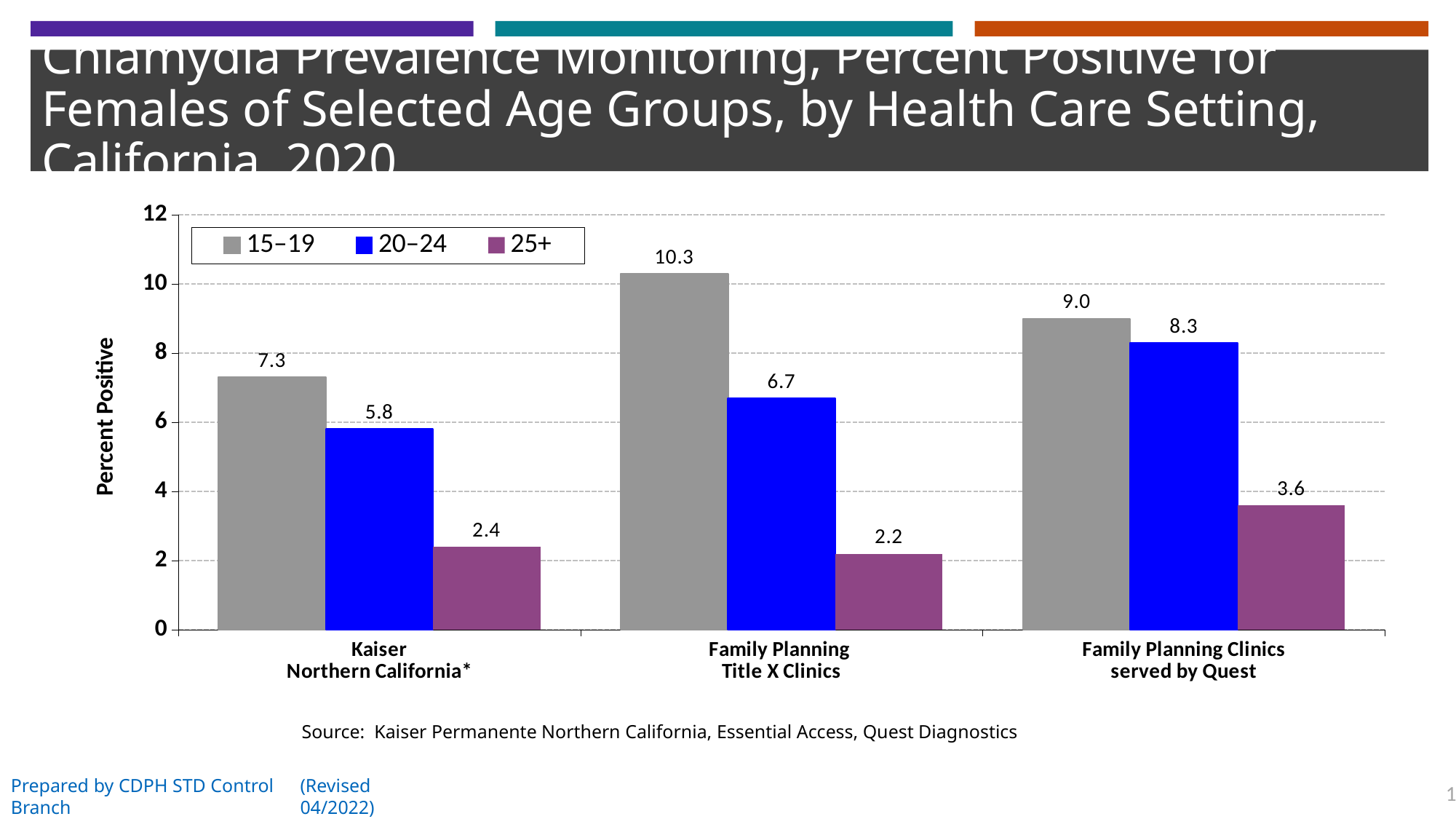
Which health care setting has the highest percent positive for the 15–19 age group? Family Planning Title X Clinics What is the difference between the 15–19 and 20–24 percent positive values at Kaiser Northern California? 1.5 How many health care settings are shown on the x axis? 3 What is the difference between the 20–24 percent positive at Family Planning Clinics served by Quest and at Family Planning Title X Clinics? 1.6 What is the percent positive for the 25+ age group at Kaiser Northern California? 2.4 Which health care setting has the lowest percent positive for the 25+ age group? Family Planning Title X Clinics How many age groups does the legend list? 3 Which is larger: the 20–24 value at Kaiser Northern California or the 20–24 value at Family Planning Title X Clinics? Family Planning Title X Clinics What is the percent positive for the 15–19 age group at Family Planning Title X Clinics? 10.3 Is the value for the 15–19 age group at Family Planning Clinics served by Quest greater or less than 8? greater What kind of chart is shown on the slide? Bar chart What is the percent positive for the 20–24 age group at Family Planning Clinics served by Quest? 8.3